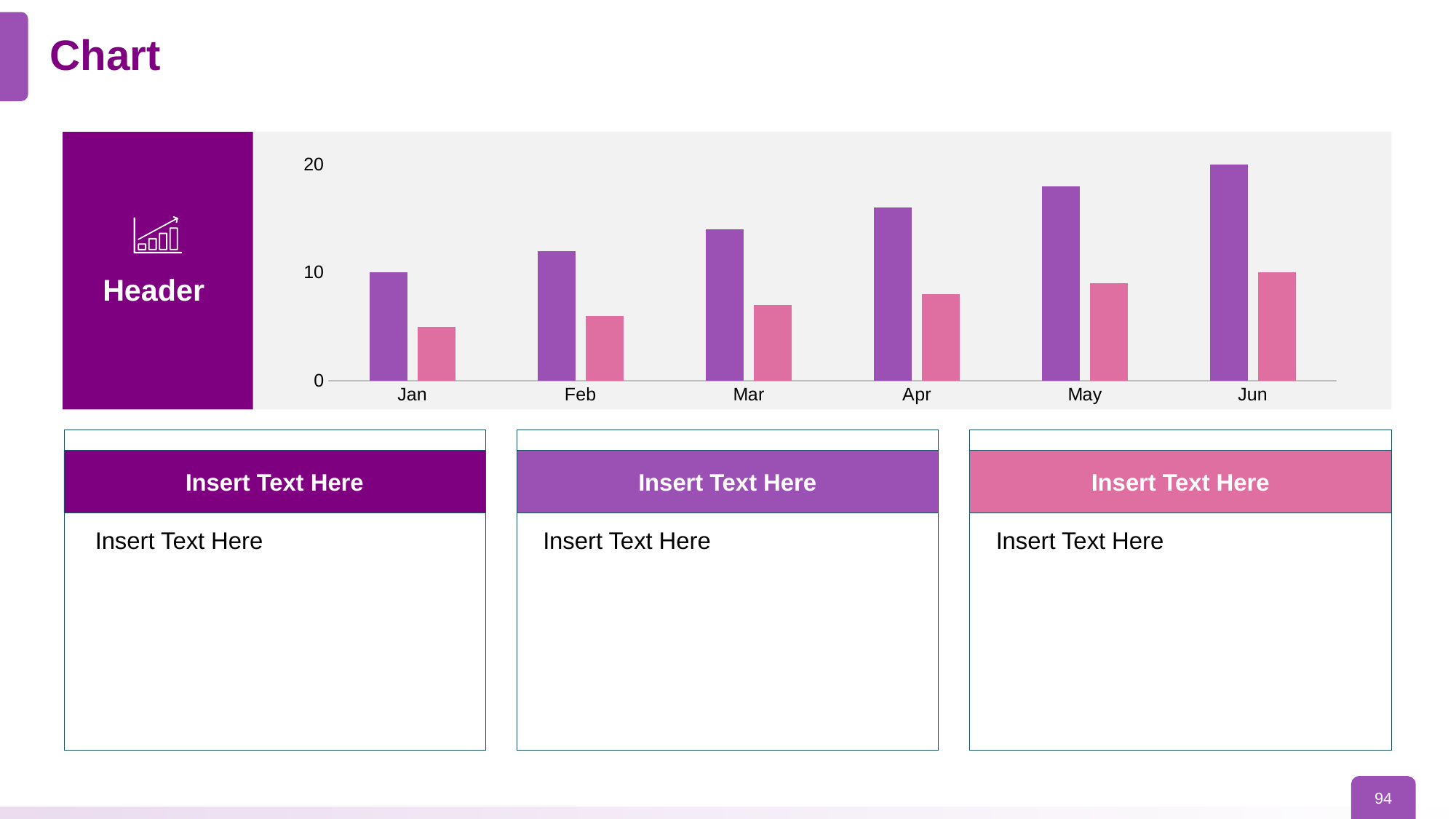
Is the pink bar for Mar greater or less than 10? less Do the purple bars rise or fall from Jan to Jun? rise How many categories are shown on the x axis of the chart? 6 Do the pink bars rise or fall from Jan to Jun? rise What kind of chart is shown on the slide? bar chart Which month has the shortest pink bar? Jan Is the purple bar for May greater or less than 20? less Which month has the tallest purple bar? Jun What is the value of the purple bar for Jun? 20 Which month has the shortest purple bar? Jan In Feb, which bar is taller, the purple bar or the pink bar? purple Is the purple bar for Apr greater or less than 10? greater